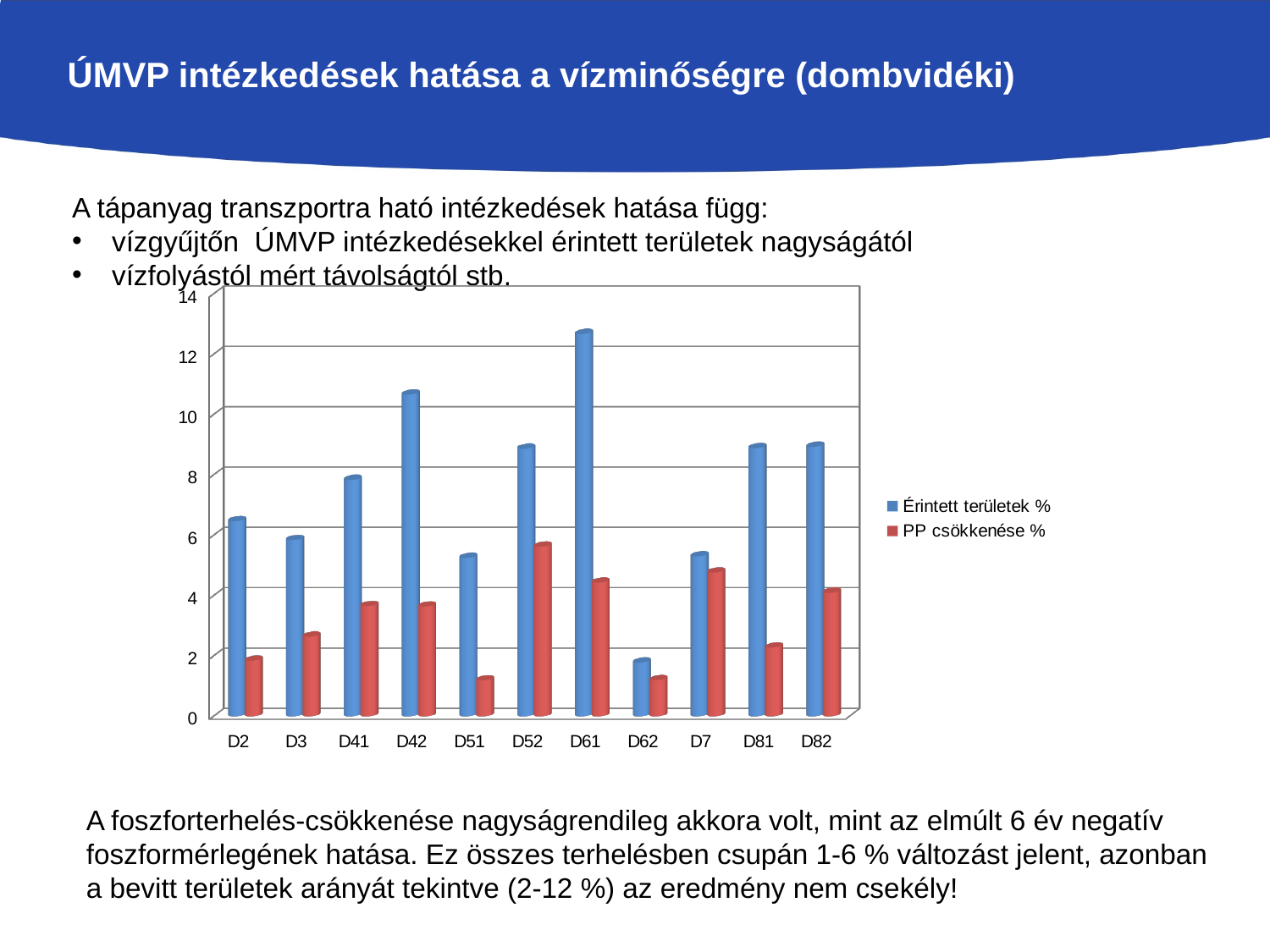
Is the PP csökkenése % value for D52 greater or less than 4? greater Which category has the highest value for PP csökkenése %? D52 Which has the larger Érintett területek % value, D42 or D52? D42 Which category has the lowest value for Érintett területek %? D62 Is the Érintett területek % value for D61 greater or less than 12? greater Which category has the highest value for Érintett területek %? D61 How many series does the chart's legend list? 2 How many categories are shown on the x axis of the chart? 11 Is the Érintett területek % value for D62 greater or less than 2? less What kind of chart is shown on the slide? bar chart Which has the larger PP csökkenése % value, D7 or D81? D7